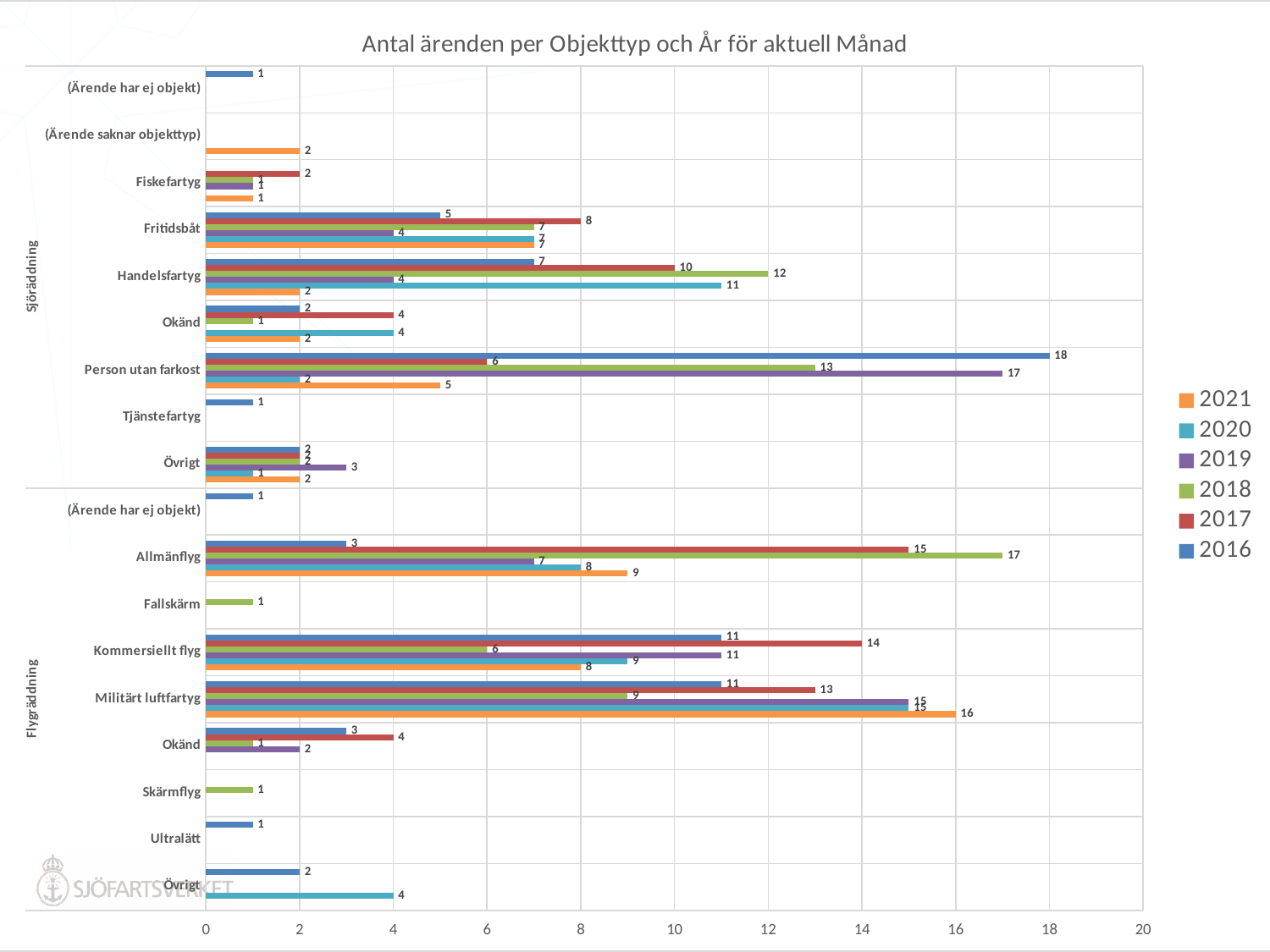
What is the title of the chart? Antal ärenden per Objekttyp och År för aktuell Månad Which year has the lowest value for Handelsfartyg under Sjöräddning? 2021 How many series does the legend list? 6 Which year has the highest value for Kommersiellt flyg under Flygräddning? 2017 What is the value for Handelsfartyg in 2018 under Sjöräddning? 12 What is the value for Allmänflyg in 2017 under Flygräddning? 15 Which is larger for Fritidsbåt under Sjöräddning: the 2017 value or the 2019 value? 2017 What is the value for Person utan farkost in 2016 under Sjöräddning? 18 What is the value for Militärt luftfartyg in 2021 under Flygräddning? 16 What is the difference between the 2016 and 2019 values for Person utan farkost under Sjöräddning? 1 What is the value for Övrigt in 2020 under Flygräddning? 4 What type of chart is shown on the slide? Bar chart